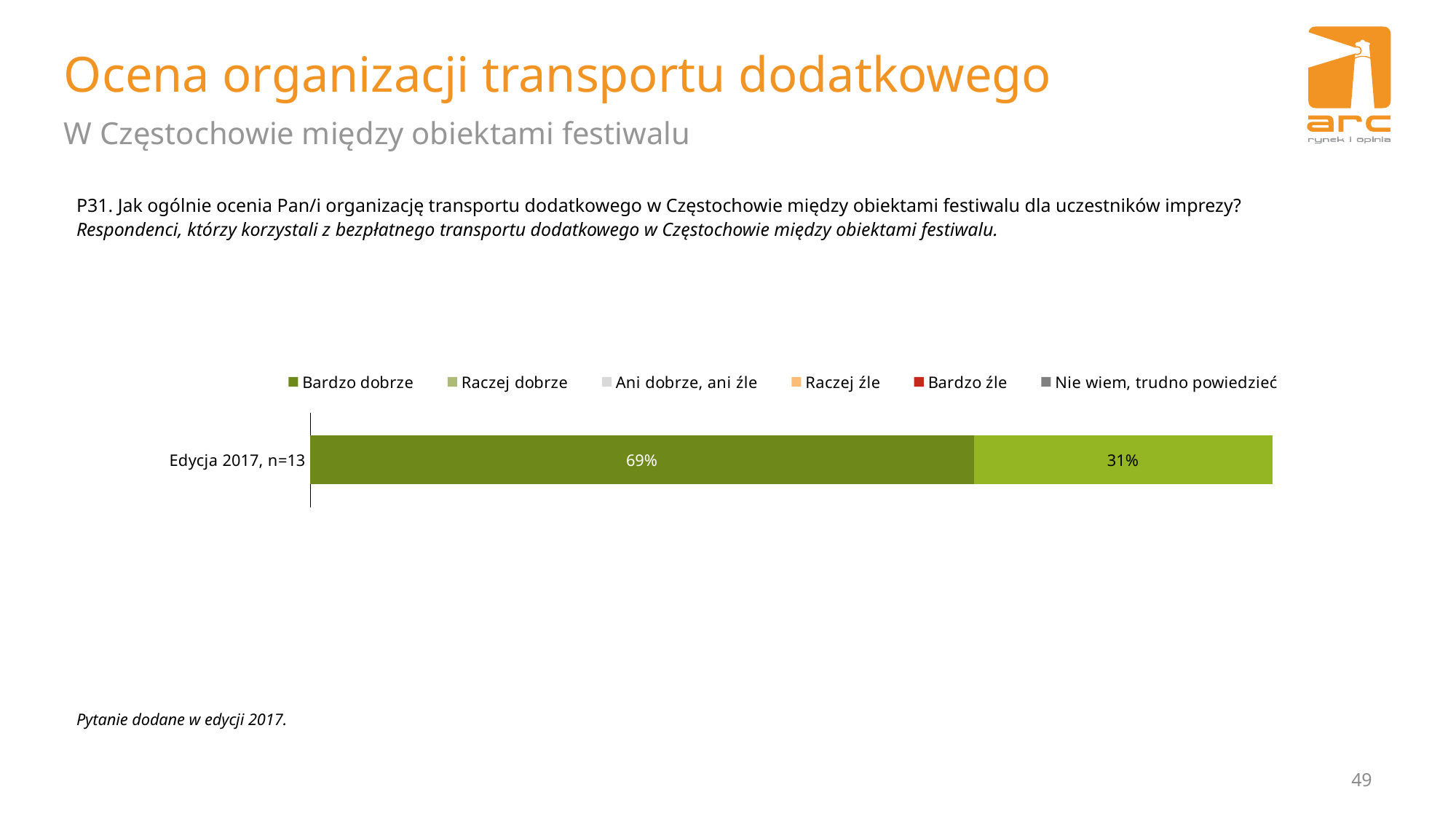
What is the total of the Edycja 2017, n=13 stacked bar? 100% Which is larger for Edycja 2017, n=13: "Bardzo dobrze" or "Raczej dobrze"? Bardzo dobrze What is the value for "Bardzo dobrze" for Edycja 2017, n=13? 69% What is the difference between the "Bardzo dobrze" and "Raczej dobrze" values for Edycja 2017, n=13? 38 percentage points Which series has the largest share of the Edycja 2017, n=13 bar? Bardzo dobrze How many series does the legend list? 6 Which legend entry is shown in red? Bardzo źle What is the value for "Raczej dobrze" for Edycja 2017, n=13? 31% What kind of chart is shown on the slide? Stacked bar chart How many categories are plotted on the chart? 1 What is the label of the only category on the chart? Edycja 2017, n=13